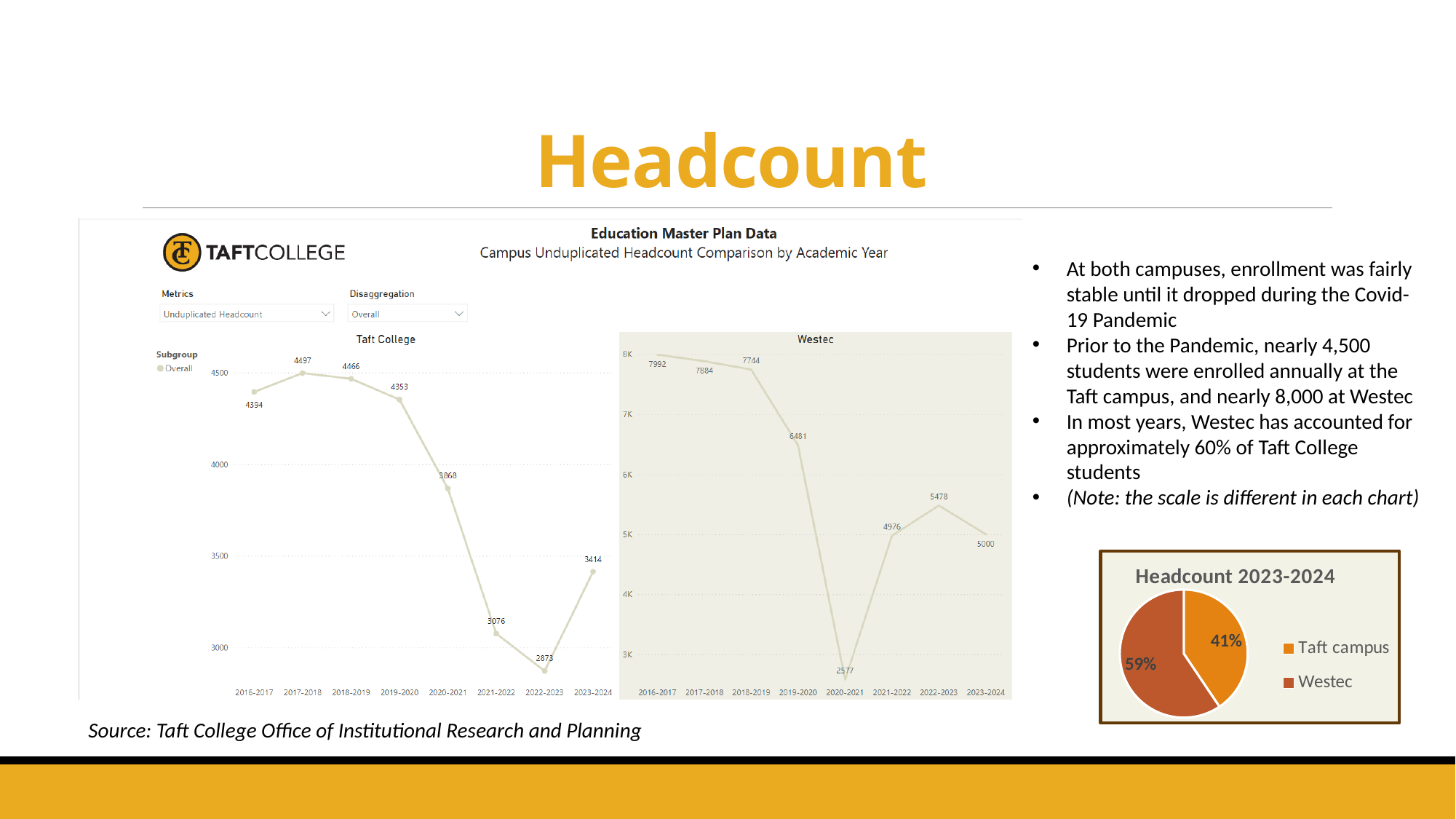
In the Westec chart, is the headcount for 2022-2023 larger or smaller than the headcount for 2023-2024? larger In the Taft College chart, does the headcount rise or fall from 2019-2020 to 2022-2023? fall In the Westec chart, what is the headcount for 2020-2021? 2577 In the Taft College chart, what is the difference between the 2016-2017 and 2023-2024 headcounts? 980 In the Taft College chart, which academic year has the lowest headcount? 2022-2023 How many academic years are plotted in the Taft College chart? 8 How many entries does the legend of the Headcount 2023-2024 pie chart list? 2 In the Taft College chart, what is the headcount for 2017-2018? 4497 In the Headcount 2023-2024 pie chart, what share does Westec account for? 59% In the Westec chart, which academic year has the highest headcount? 2016-2017 What kind of chart is the Westec chart? line chart In the Westec chart, what is the difference between the 2019-2020 and 2020-2021 headcounts? 3904